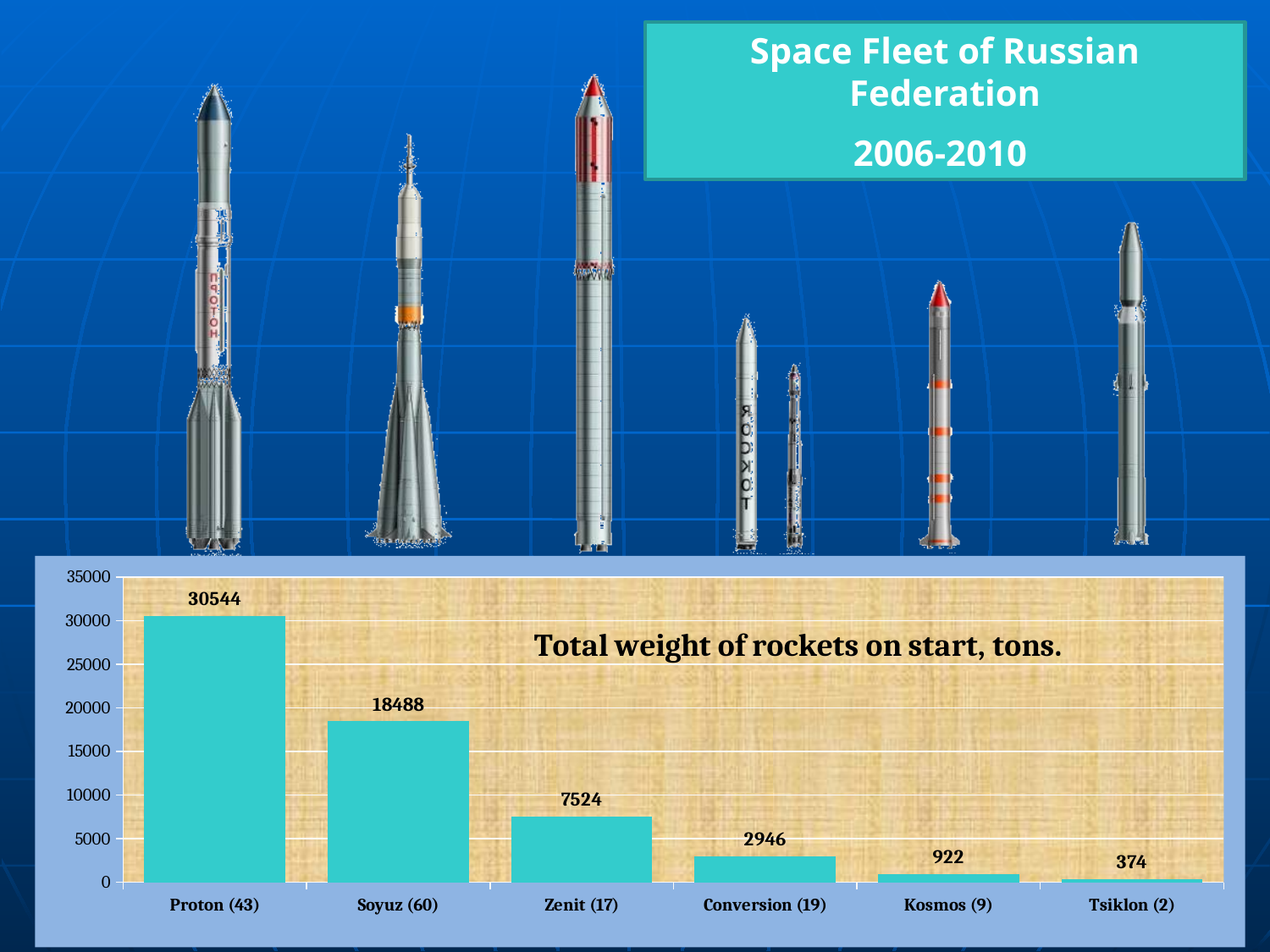
How many categories are shown on the x axis of the chart? 6 Which category has the highest total weight of rockets on start? Proton (43) What is the value shown for Zenit (17)? 7524 What is the total weight of rockets on start for Proton (43)? 30544 Do the values rise or fall from left to right along the x axis? fall What is the difference between the values for Conversion (19) and Kosmos (9)? 2024 Which category has the lowest total weight of rockets on start? Tsiklon (2) What kind of chart is shown on the slide? bar chart Which is larger, the value for Zenit (17) or the value for Conversion (19)? Zenit (17) What is the difference between the values for Proton (43) and Soyuz (60)? 12056 What is the value shown for Kosmos (9)? 922 What is the value shown for Soyuz (60)? 18488